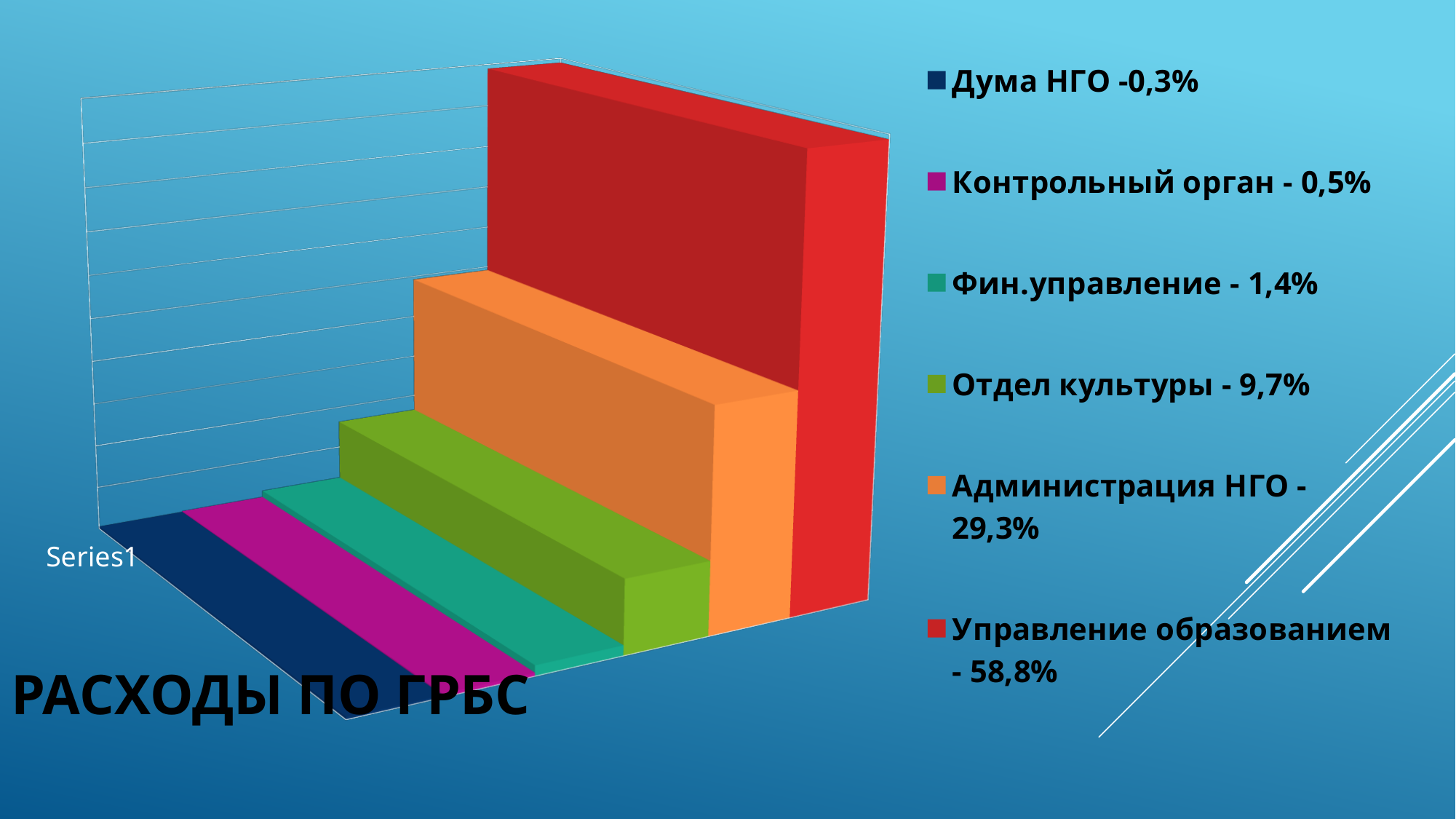
How many entries does the legend list? 6 What percentage is shown for Фин.управление? 1,4% What kind of chart is shown on the slide? bar chart What percentage is shown for Администрация НГО? 29,3% What is the difference between the values for Управление образованием and Администрация НГО? 29,5% How many categories are shown in the chart? 6 What is the title of the chart on the slide? РАСХОДЫ ПО ГРБС What percentage is shown for Управление образованием? 58,8% What percentage is shown for Отдел культуры? 9,7% Which is larger, the value for Отдел культуры or the value for Фин.управление? Отдел культуры Which category has the highest value? Управление образованием Which category has the lowest value? Дума НГО